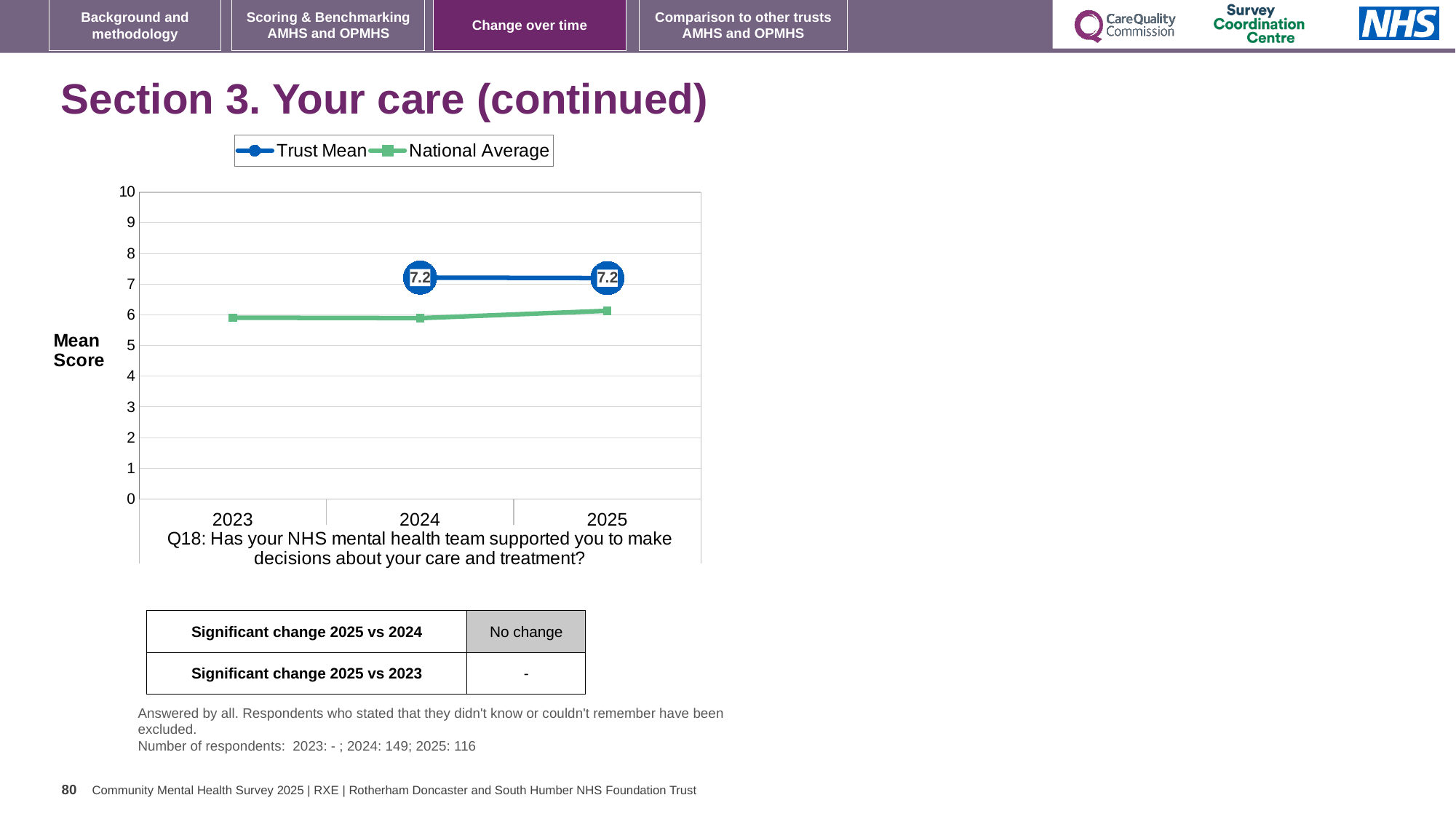
Is the National Average value for 2023 greater or less than 7? less What kind of chart is shown on the slide? line chart Does the National Average rise or fall from 2024 to 2025? rise In 2025, which is larger: the Trust Mean or the National Average? Trust Mean What is the label on the y axis of the chart? Mean Score Does the Trust Mean rise, fall or stay the same from 2024 to 2025? stays the same How many series does the legend list? 2 What is the Trust Mean value for 2025? 7.2 What is the difference between the Trust Mean in 2025 and the Trust Mean in 2024? 0 Is the National Average value for 2025 greater or less than 5? greater What is the Trust Mean value for 2024? 7.2 How many years are shown on the x axis? 3